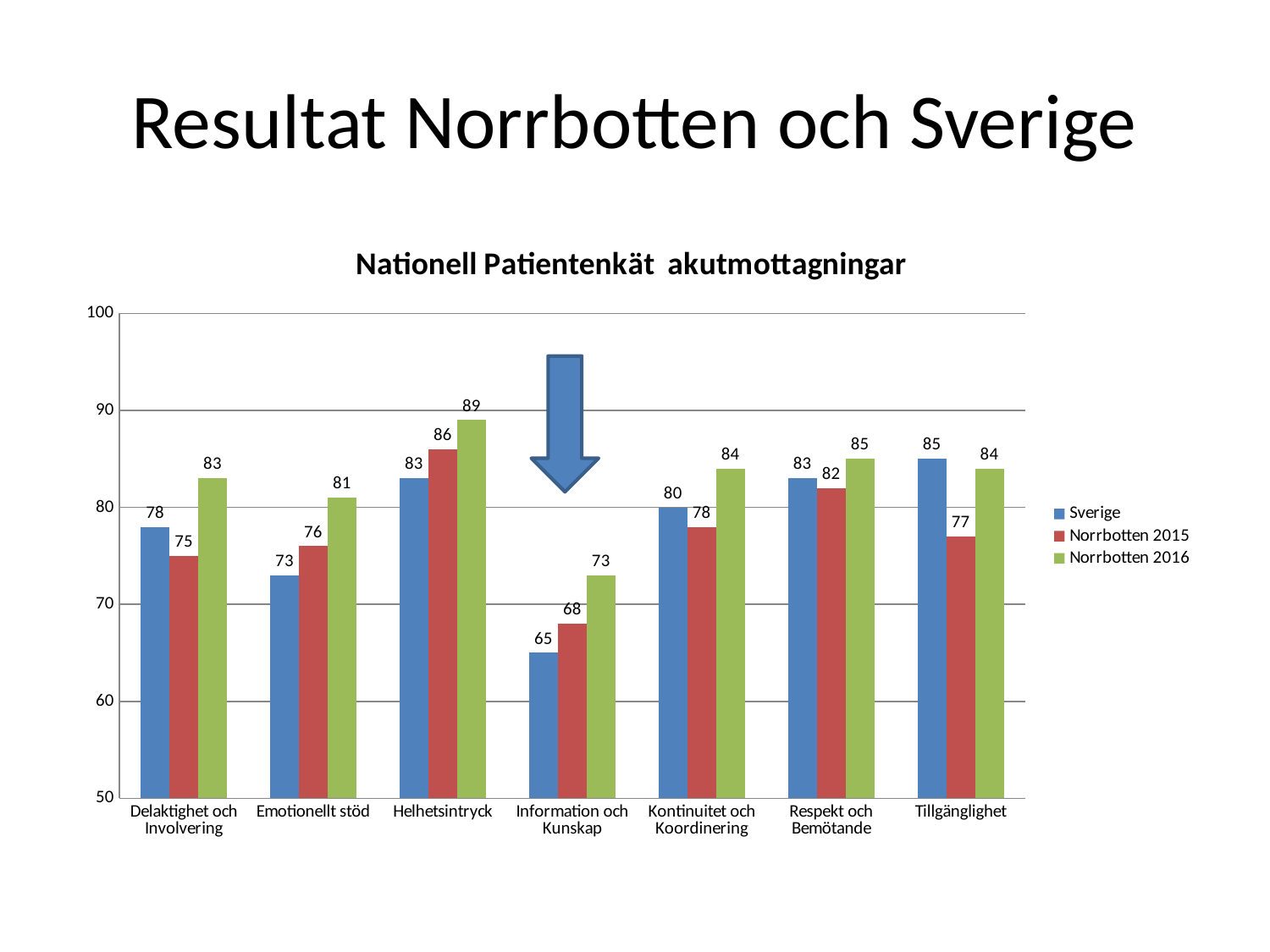
What kind of chart is shown on the slide? Bar chart Which category has the lowest Norrbotten 2016 value? Information och Kunskap Which is larger for Respekt och Bemötande: the Sverige value or the Norrbotten 2015 value? Sverige What is the Sverige value for Information och Kunskap? 65 What is the value for Norrbotten 2016 in the Helhetsintryck category? 89 What is the difference between the Norrbotten 2016 and Norrbotten 2015 values for Delaktighet och Involvering? 8 Which series is shown in green in the legend? Norrbotten 2016 What is the title of the chart? Nationell Patientenkät akutmottagningar How many categories are shown on the x axis? 7 Which category has the highest Sverige value? Tillgänglighet What is the Norrbotten 2015 value for Tillgänglighet? 77 How many series does the legend list? 3